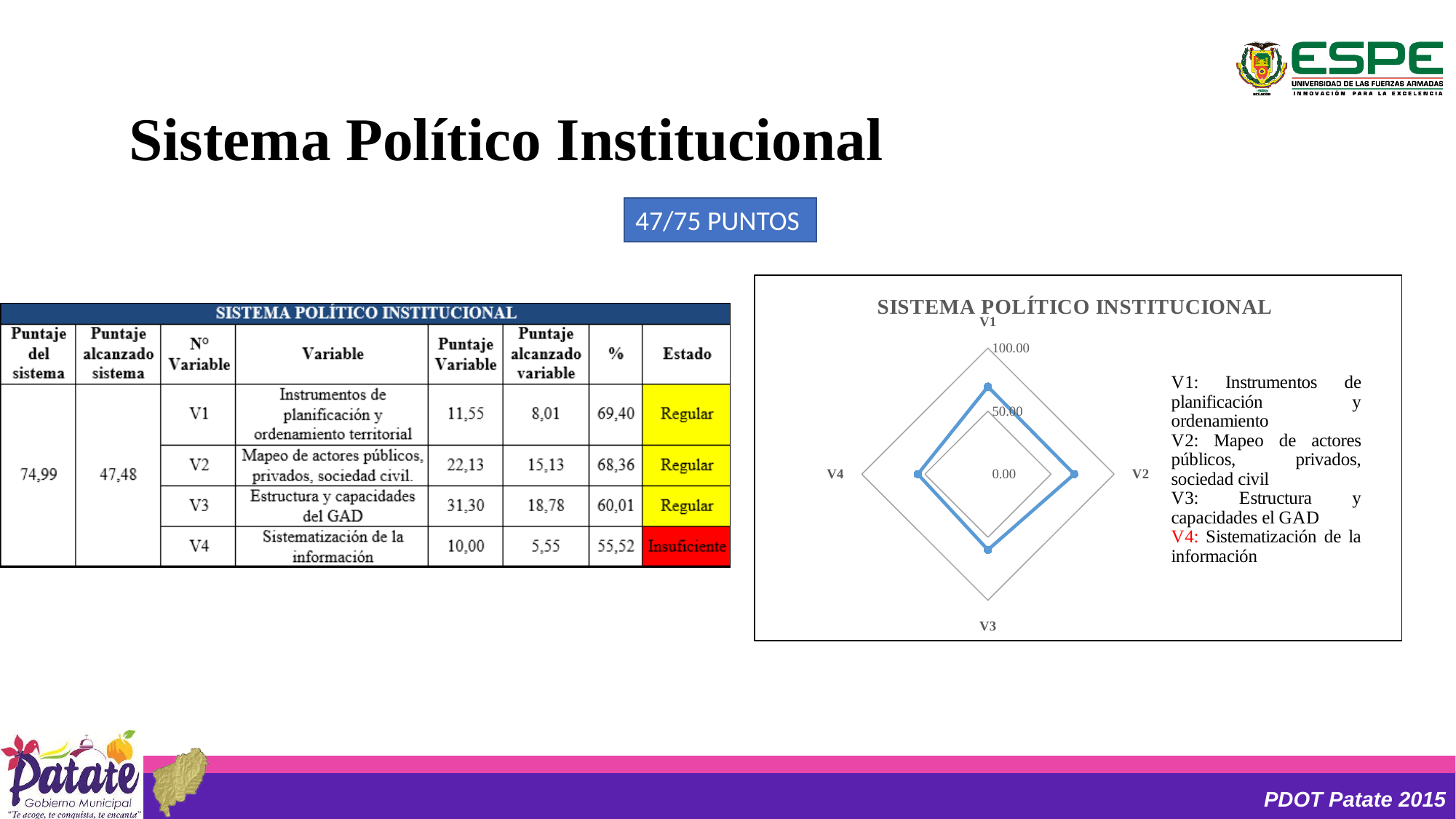
What is the highest value shown on the radar chart's scale? 100.00 What is the title of the radar chart? SISTEMA POLÍTICO INSTITUCIONAL How many variables (axes) are plotted on the radar chart? 4 What kind of chart is shown on the right side of the slide? Radar chart On the radar chart, is the value for V3 greater or less than 100.00? less On the radar chart, which has the larger value, V1 or V4? V1 On the radar chart, is the value for V1 greater or less than 50.00? greater On the radar chart, is the value for V2 greater or less than 50.00? greater On the radar chart, which has the larger value, V2 or V4? V2 Which axis label appears at the bottom of the radar chart? V3